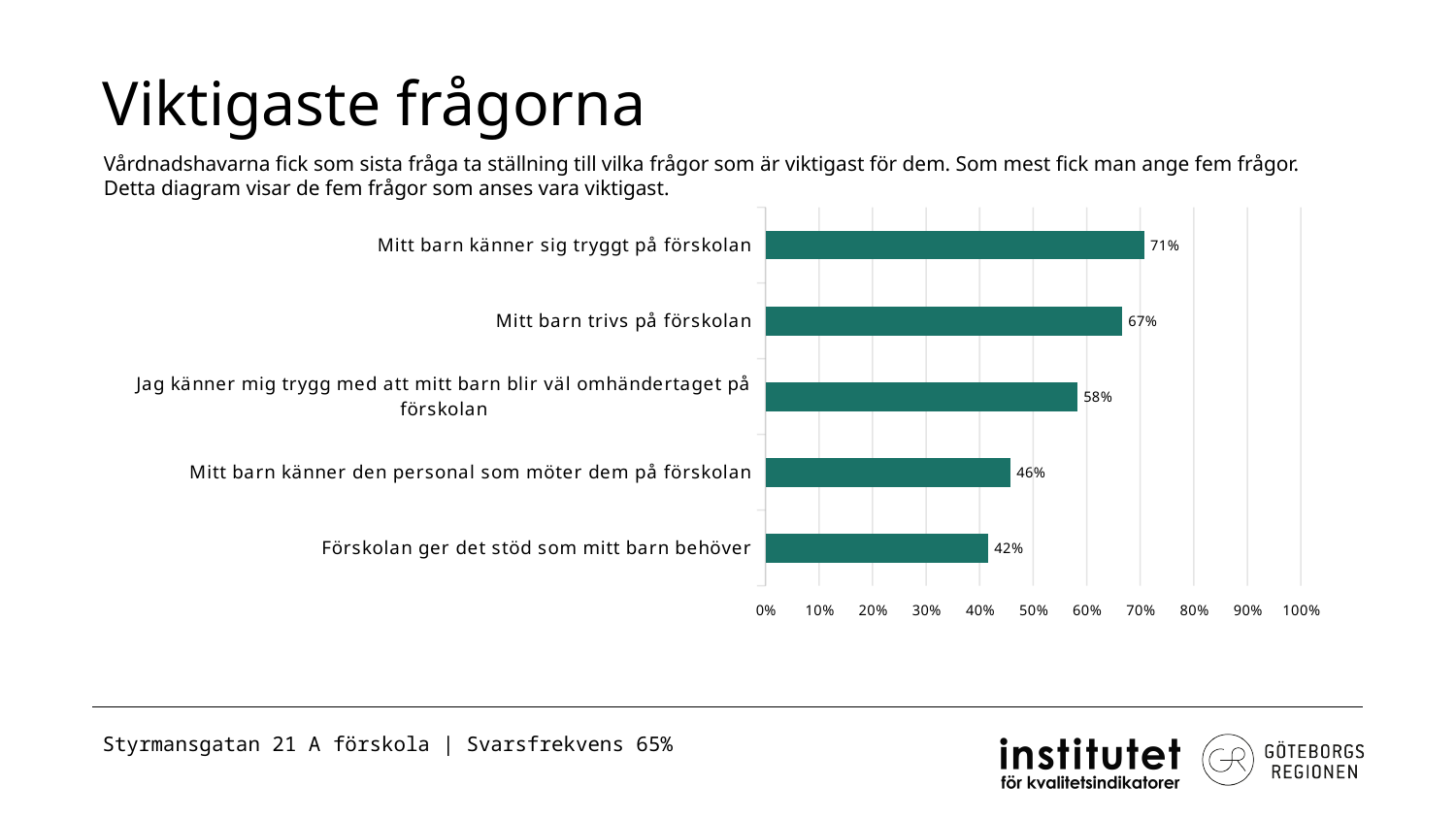
How many categories are shown in the chart? 5 What is the value for "Förskolan ger det stöd som mitt barn behöver"? 42% What kind of chart is shown on the slide? bar chart Which category has the highest value? Mitt barn känner sig tryggt på förskolan What is the value for "Mitt barn känner sig tryggt på förskolan"? 71% What is the maximum value shown on the x axis? 100% What is the value for "Jag känner mig trygg med att mitt barn blir väl omhändertaget på förskolan"? 58% Which is larger: the value for "Mitt barn trivs på förskolan" or for "Jag känner mig trygg med att mitt barn blir väl omhändertaget på förskolan"? Mitt barn trivs på förskolan Which category has the lowest value? Förskolan ger det stöd som mitt barn behöver What is the difference between the values for "Mitt barn trivs på förskolan" and "Mitt barn känner den personal som möter dem på förskolan"? 21% What is the title of the slide? Viktigaste frågorna Is the value for "Mitt barn känner den personal som möter dem på förskolan" greater or less than 50%? less